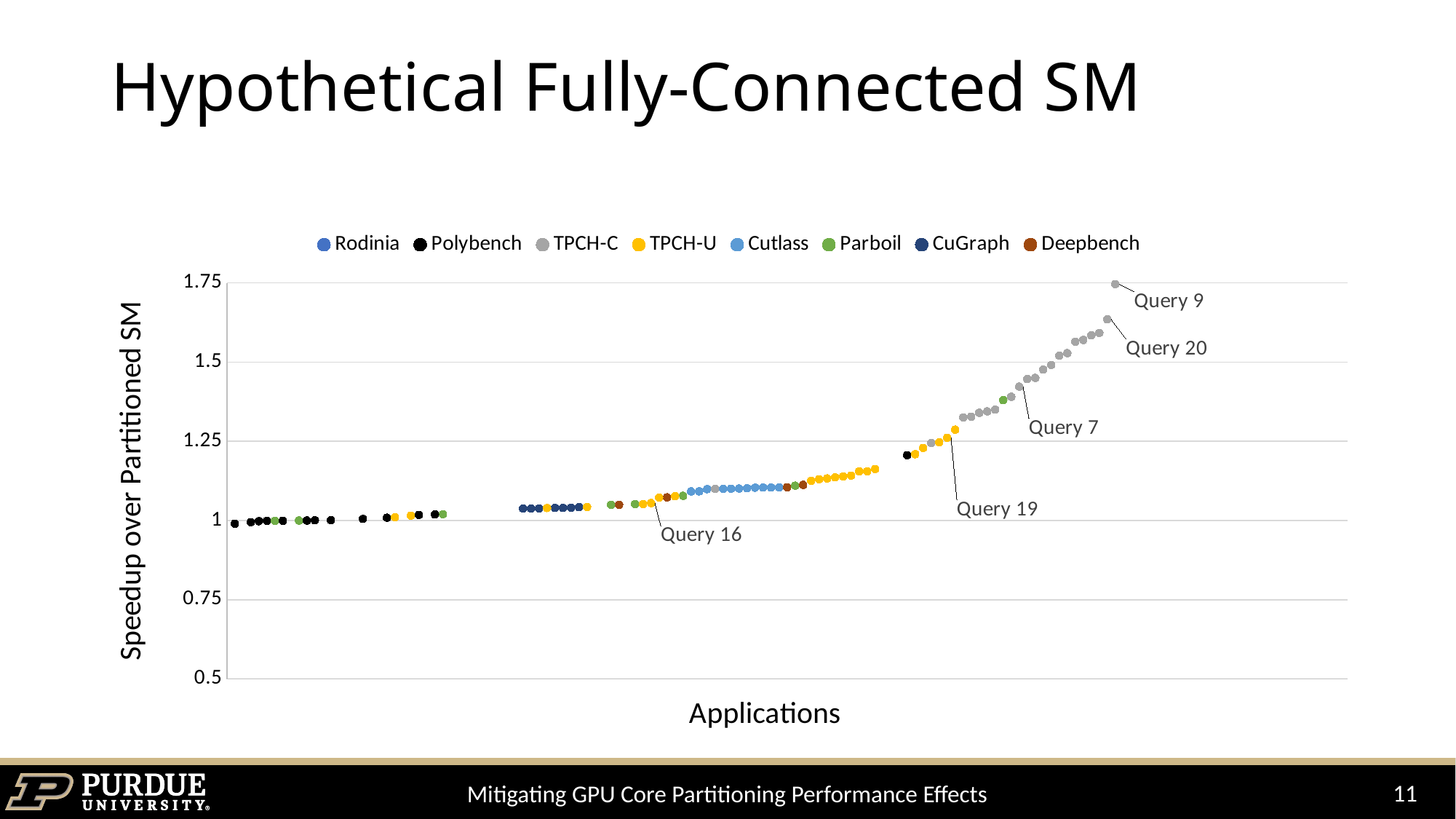
Is the speedup for Query 20 greater or less than 1.5? greater How many series does the legend list? 8 What kind of chart is shown on the slide? scatter chart Do the plotted speedup values rise or fall from left to right along the x axis? rise Which has the larger speedup, Query 20 or Query 7? Query 20 Which labelled query has the highest speedup over Partitioned SM? Query 9 Is the speedup for Query 7 greater or less than 1.5? less Is the speedup for Query 16 greater or less than 1.25? less Which labelled query has the lowest speedup over Partitioned SM? Query 16 What is the title of the y axis? Speedup over Partitioned SM